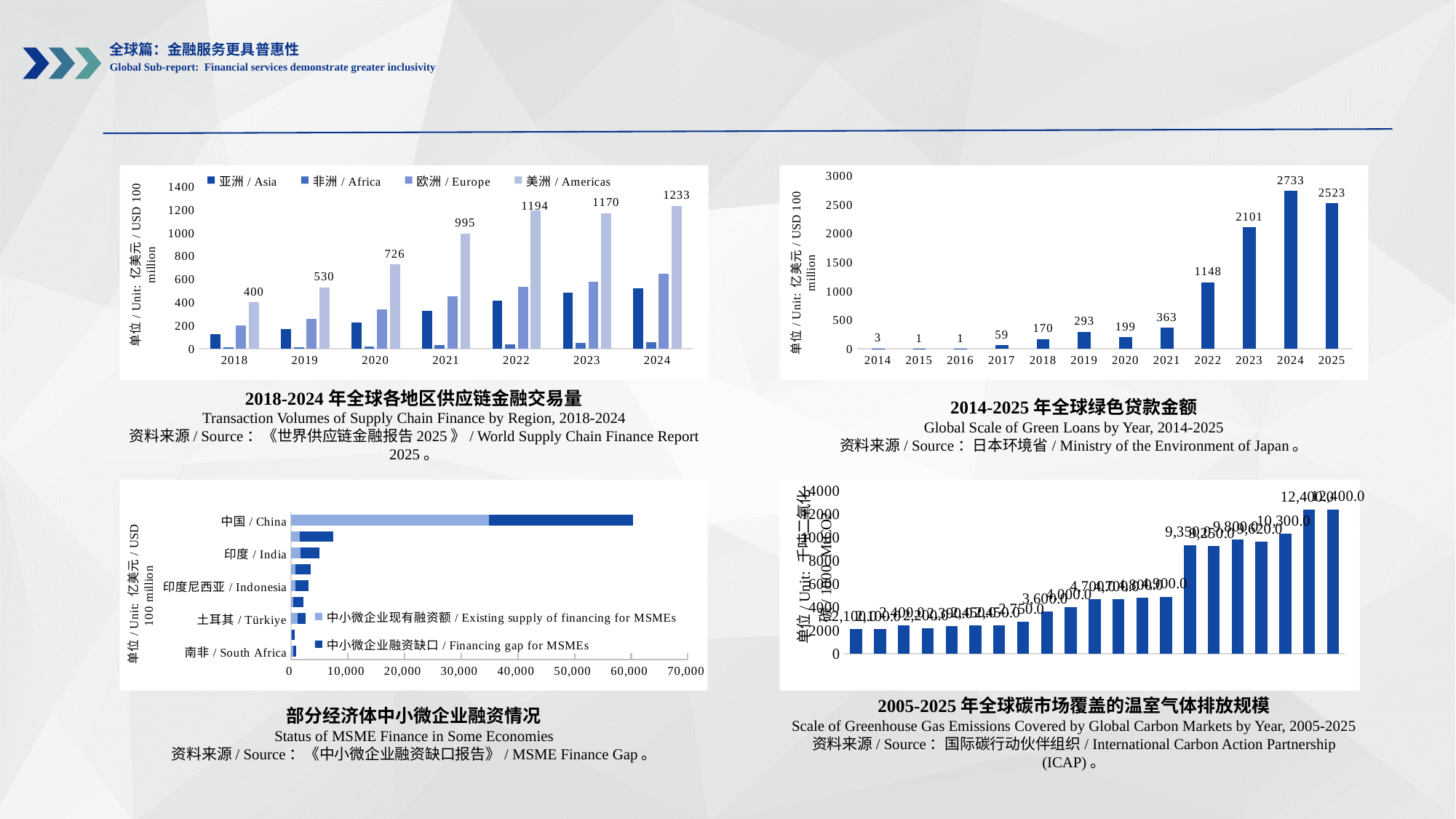
In the chart titled 'Global Scale of Green Loans by Year, 2014-2025', what is the value for 2017? 59 In the chart titled 'Transaction Volumes of Supply Chain Finance by Region, 2018-2024', what is the value for Americas in 2021? 995 In the chart titled 'Status of MSME Finance in Some Economies', which economy has the longest total bar? China In the chart titled 'Transaction Volumes of Supply Chain Finance by Region, 2018-2024', how many series does the legend list? 4 What kind of chart is the one titled 'Status of MSME Finance in Some Economies'? bar chart In the chart titled 'Global Scale of Green Loans by Year, 2014-2025', what is the difference between the 2024 value and the 2025 value? 210 In the chart titled 'Global Scale of Green Loans by Year, 2014-2025', what is the value for 2024? 2733 In the chart titled 'Global Scale of Green Loans by Year, 2014-2025', which is larger, the value for 2021 or the value for 2022? 2022 In the chart titled 'Transaction Volumes of Supply Chain Finance by Region, 2018-2024', what is the difference between the Americas value in 2024 and in 2018? 833 In the chart titled 'Transaction Volumes of Supply Chain Finance by Region, 2018-2024', is the value for Asia in 2024 greater or less than 400? greater In the chart titled 'Status of MSME Finance in Some Economies', how many economies are shown? 9 In the chart titled 'Global Scale of Green Loans by Year, 2014-2025', which year has the highest value? 2024